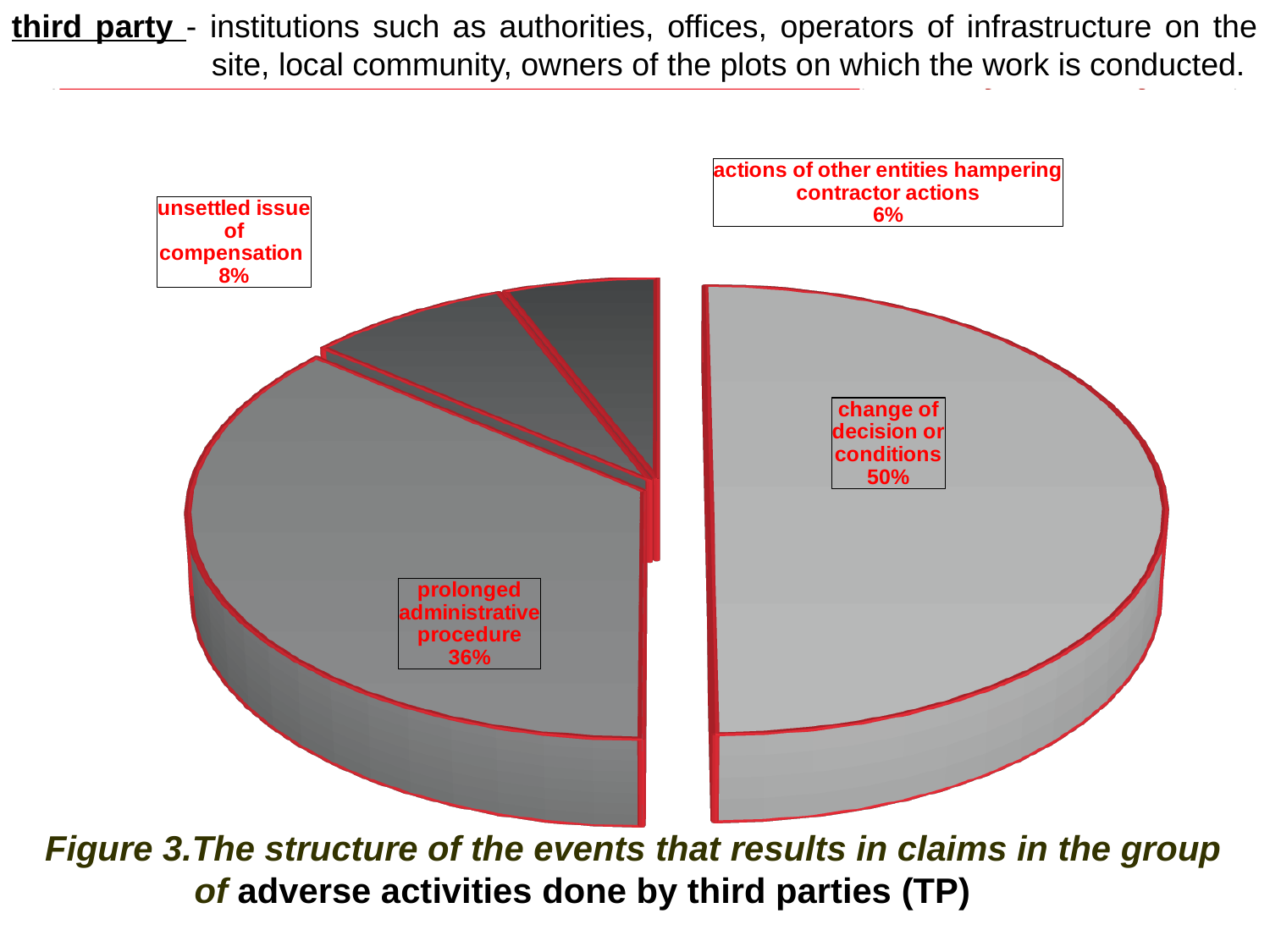
Which category has the smallest share of the pie? actions of other entities hampering contractor actions How many slices does the pie chart have? 4 What share of the pie is 'change of decision or conditions'? 50% What kind of chart is shown on the slide? pie chart What is the difference in percentage points between 'change of decision or conditions' and 'prolonged administrative procedure'? 14 Which is larger: the share for 'prolonged administrative procedure' or the share for 'unsettled issue of compensation'? prolonged administrative procedure What share of the pie is 'unsettled issue of compensation'? 8% What share of the pie is 'prolonged administrative procedure'? 36% What is the figure number given in the caption below the chart? Figure 3 What share of the pie is 'actions of other entities hampering contractor actions'? 6% What is the difference in percentage points between 'unsettled issue of compensation' and 'actions of other entities hampering contractor actions'? 2 Which category has the largest share of the pie? change of decision or conditions